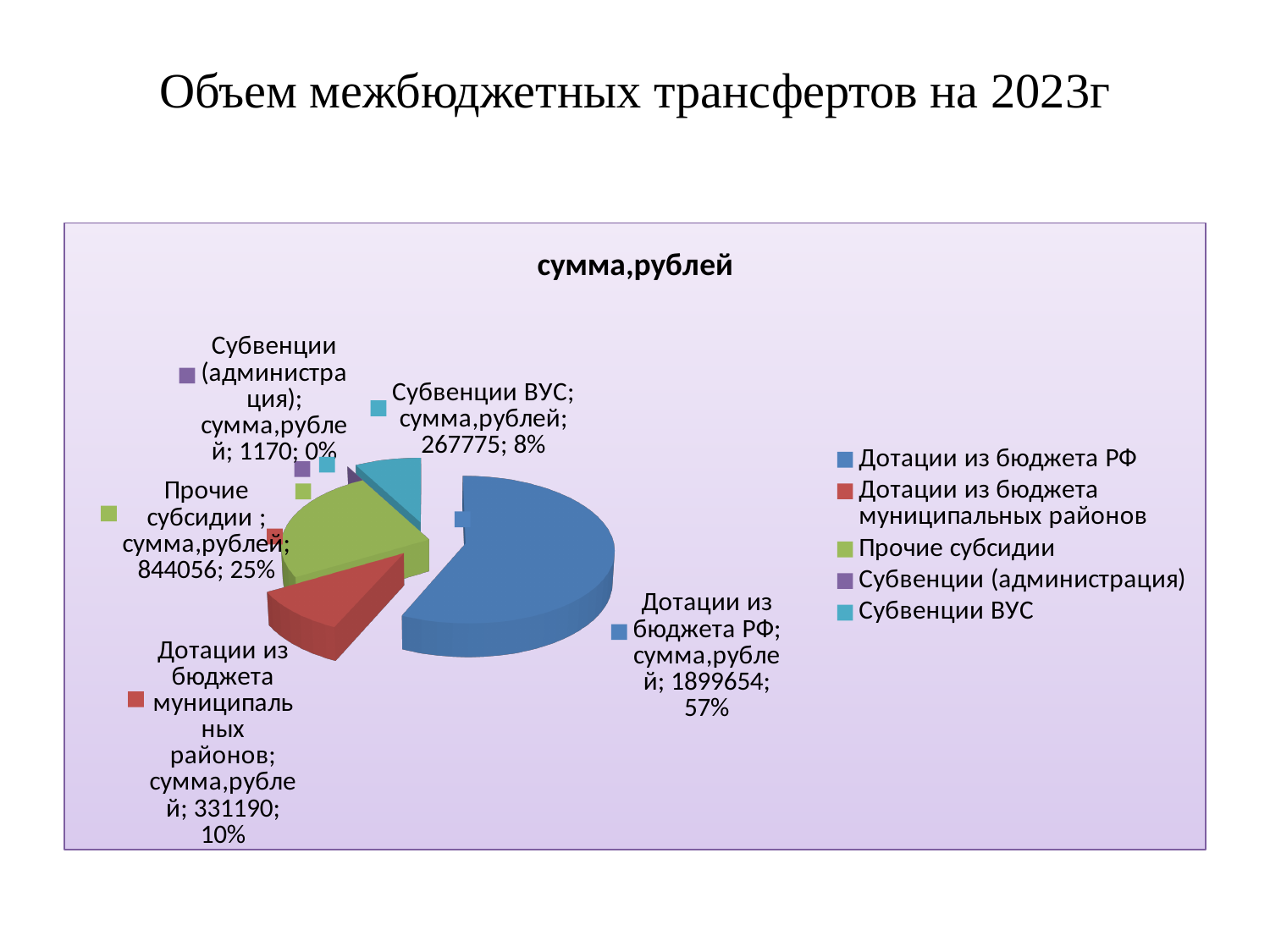
What share of the pie does Дотации из бюджета муниципальных районов represent? 10% Which is larger, the value for Дотации из бюджета муниципальных районов or the value for Субвенции ВУС? Дотации из бюджета муниципальных районов What is the difference between the values for Дотации из бюджета РФ and Прочие субсидии? 1055598 What kind of chart is shown on the slide? pie chart What is the value for Субвенции ВУС? 267775 What is the value for Дотации из бюджета муниципальных районов? 331190 What share of the pie does Прочие субсидии represent? 25% How many categories does the pie chart have? 5 Which category has the smallest slice of the pie? Субвенции (администрация) What is the value for Дотации из бюджета РФ? 1899654 What is the value for Прочие субсидии? 844056 Which category has the largest slice of the pie? Дотации из бюджета РФ